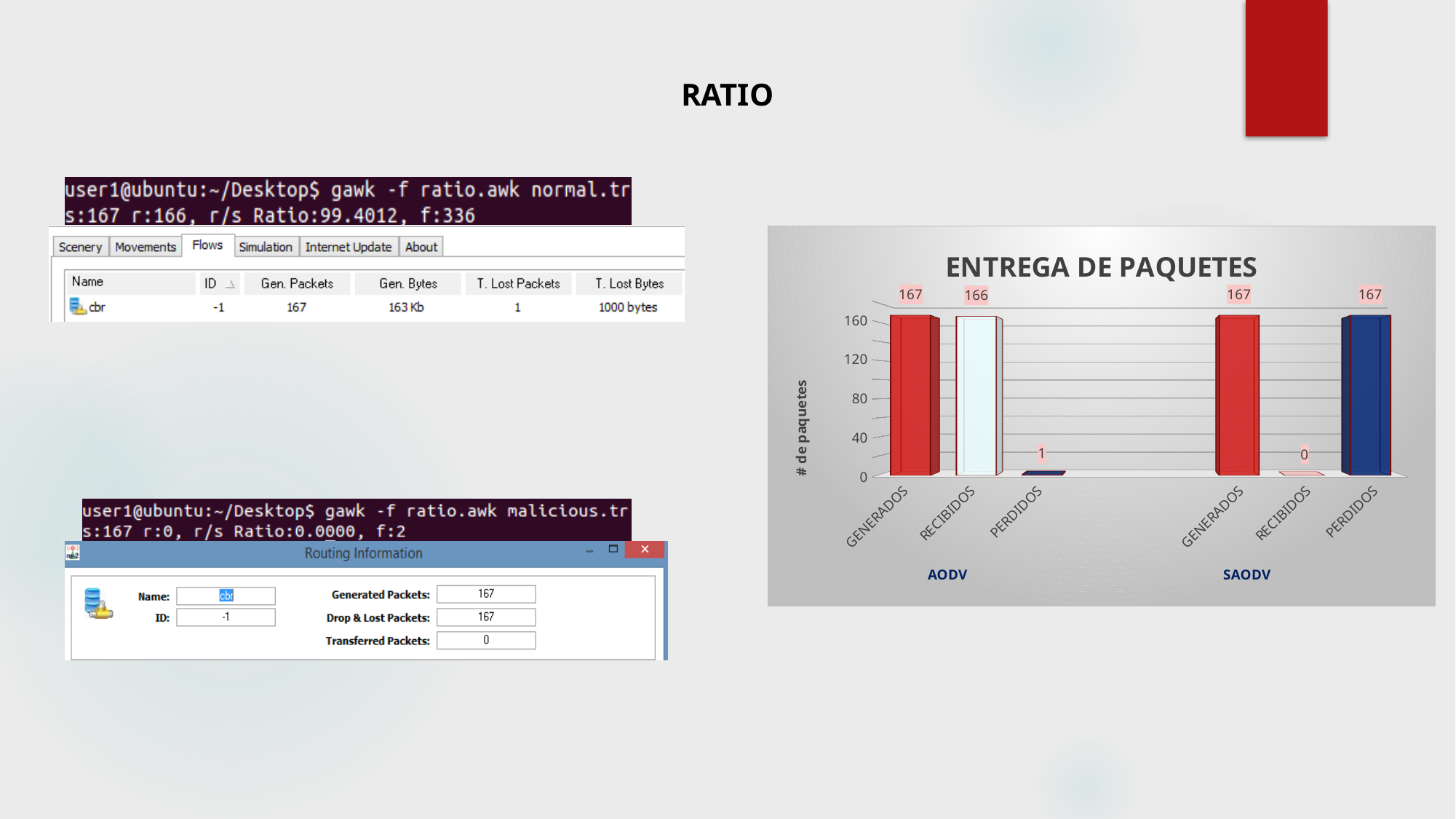
What is the value of GENERADOS for SAODV? 167 What is the difference between PERDIDOS for SAODV and PERDIDOS for AODV? 166 Which is larger, RECIBIDOS for AODV or RECIBIDOS for SAODV? RECIBIDOS for AODV What is the title of the chart on the slide? ENTREGA DE PAQUETES Which category has the lowest value in the chart? RECIBIDOS (SAODV) What is the value of RECIBIDOS for SAODV? 0 What is the difference between GENERADOS and RECIBIDOS for AODV? 1 What is the value of PERDIDOS for AODV? 1 What is the value of RECIBIDOS for AODV? 166 What type of chart is shown on the slide? bar chart How many bars are plotted in the chart? 6 What is the value of PERDIDOS for SAODV? 167